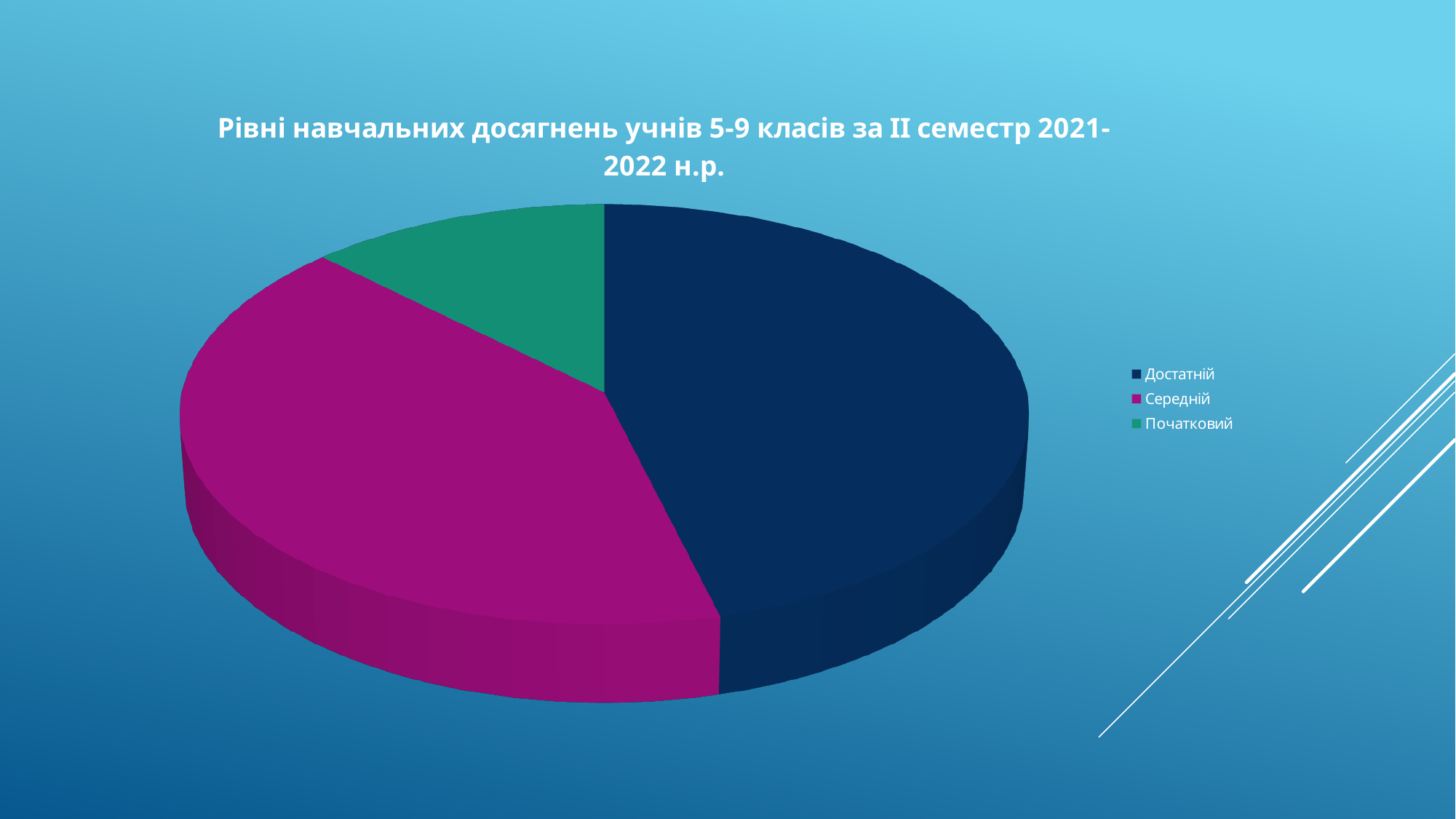
Which category has the largest slice of the pie? Достатній What is the title of the chart? Рівні навчальних досягнень учнів 5-9 класів за ІІ семестр 2021-2022 н.р. What kind of chart is shown on the slide? Pie chart Which category is shown in green in the pie chart? Початковий How many entries does the legend list? 3 Which slice is larger, Достатній or Початковий? Достатній Which slice is larger, Достатній or Середній? Достатній Which category has the smallest slice of the pie? Початковий How many slices does the pie chart have? 3 Which slice is larger, Середній or Початковий? Середній